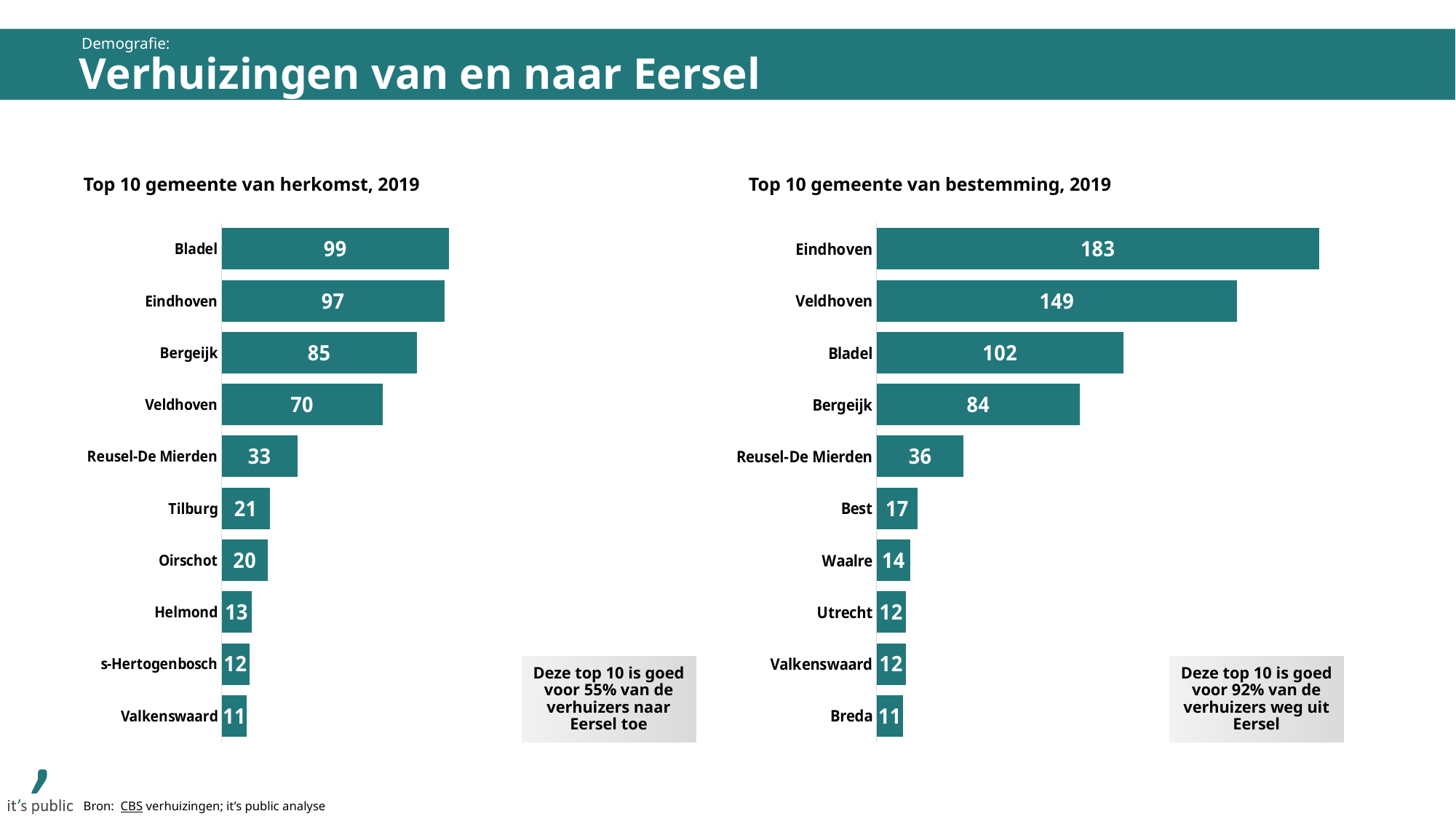
In the chart 'Top 10 gemeente van herkomst, 2019', which municipality has the highest value? Bladel In the chart 'Top 10 gemeente van herkomst, 2019', which is larger: Tilburg or Helmond? Tilburg In the chart 'Top 10 gemeente van herkomst, 2019', what is the value for Bergeijk? 85 How many municipalities are shown in the chart 'Top 10 gemeente van herkomst, 2019'? 10 In the chart 'Top 10 gemeente van bestemming, 2019', which is larger: Bladel or Bergeijk? Bladel In the chart 'Top 10 gemeente van herkomst, 2019', what is the value for Oirschot? 20 According to the text box next to the chart 'Top 10 gemeente van bestemming, 2019', what share of movers leaving Eersel does the top 10 account for? 92% In the chart 'Top 10 gemeente van bestemming, 2019', what is the difference between Eindhoven and Veldhoven? 34 In the chart 'Top 10 gemeente van herkomst, 2019', what is the difference between Veldhoven and Reusel-De Mierden? 37 In the chart 'Top 10 gemeente van bestemming, 2019', what is the value for Veldhoven? 149 What kind of chart is 'Top 10 gemeente van bestemming, 2019'? Bar chart In the chart 'Top 10 gemeente van bestemming, 2019', which municipality has the lowest value? Breda